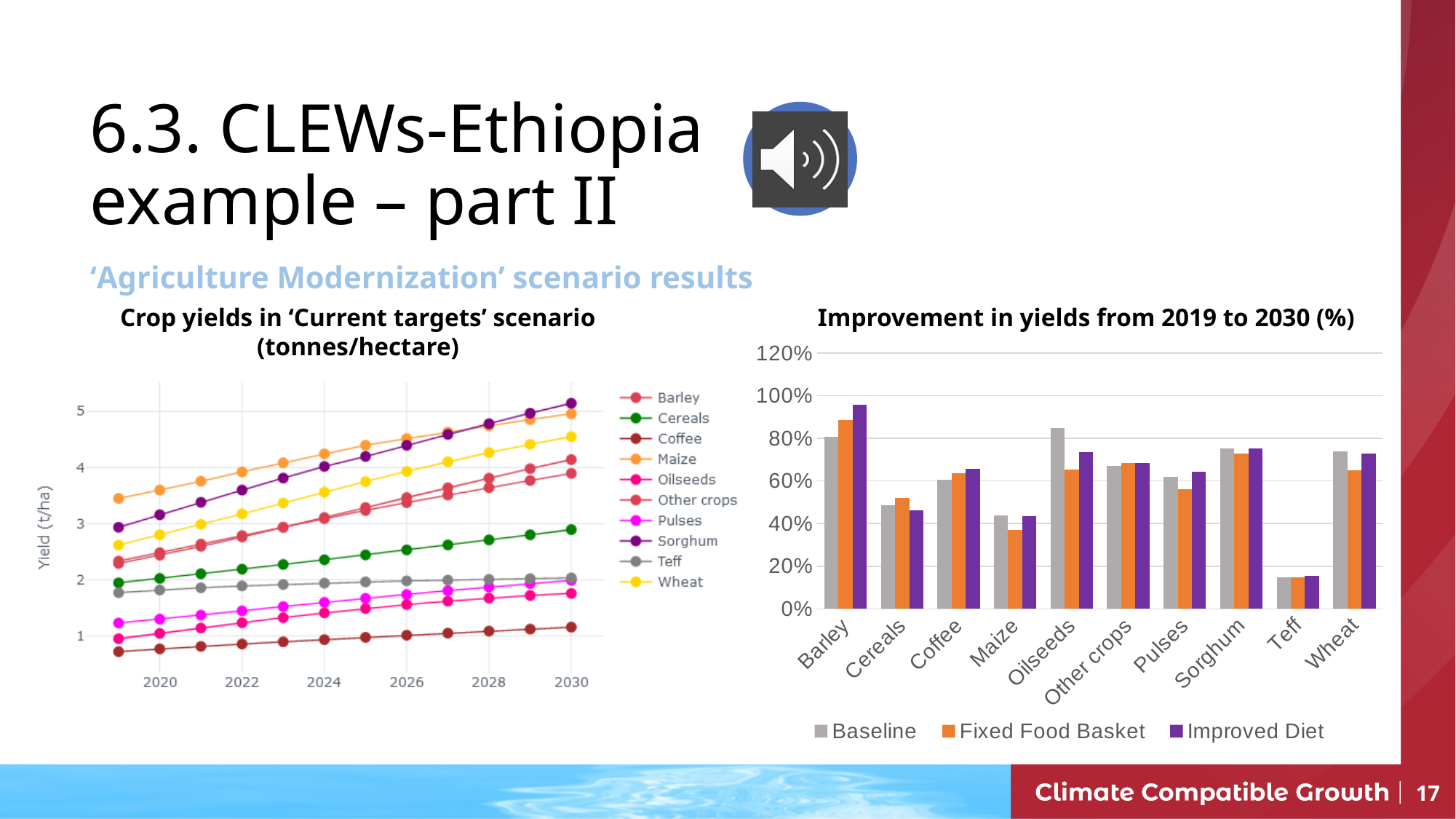
In the 'Improvement in yields from 2019 to 2030 (%)' chart, how many series does the legend list? 3 In the 'Improvement in yields from 2019 to 2030 (%)' chart, for Oilseeds, which is larger: the Baseline value or the Fixed Food Basket value? Baseline In the 'Improvement in yields from 2019 to 2030 (%)' chart, which crop has the lowest improvement across all three series? Teff In the 'Improvement in yields from 2019 to 2030 (%)' chart, is the Improved Diet value for Barley greater or less than 80%? greater In the 'Crop yields in Current targets scenario (tonnes/hectare)' chart, do the crop yields rise or fall from 2020 to 2030? Rise In the 'Crop yields in Current targets scenario (tonnes/hectare)' chart, which crop has the lowest yield throughout the period? Coffee In the 'Crop yields in Current targets scenario (tonnes/hectare)' chart, how many crops does the legend list? 10 In the 'Improvement in yields from 2019 to 2030 (%)' chart, which crop has the highest Baseline value? Oilseeds In the 'Improvement in yields from 2019 to 2030 (%)' chart, how many crop categories are shown on the x axis? 10 In the 'Improvement in yields from 2019 to 2030 (%)' chart, is the Fixed Food Basket value for Maize greater or less than 40%? less What kind of chart is the 'Crop yields in Current targets scenario (tonnes/hectare)' chart? Line chart What kind of chart is the 'Improvement in yields from 2019 to 2030 (%)' chart? Bar chart